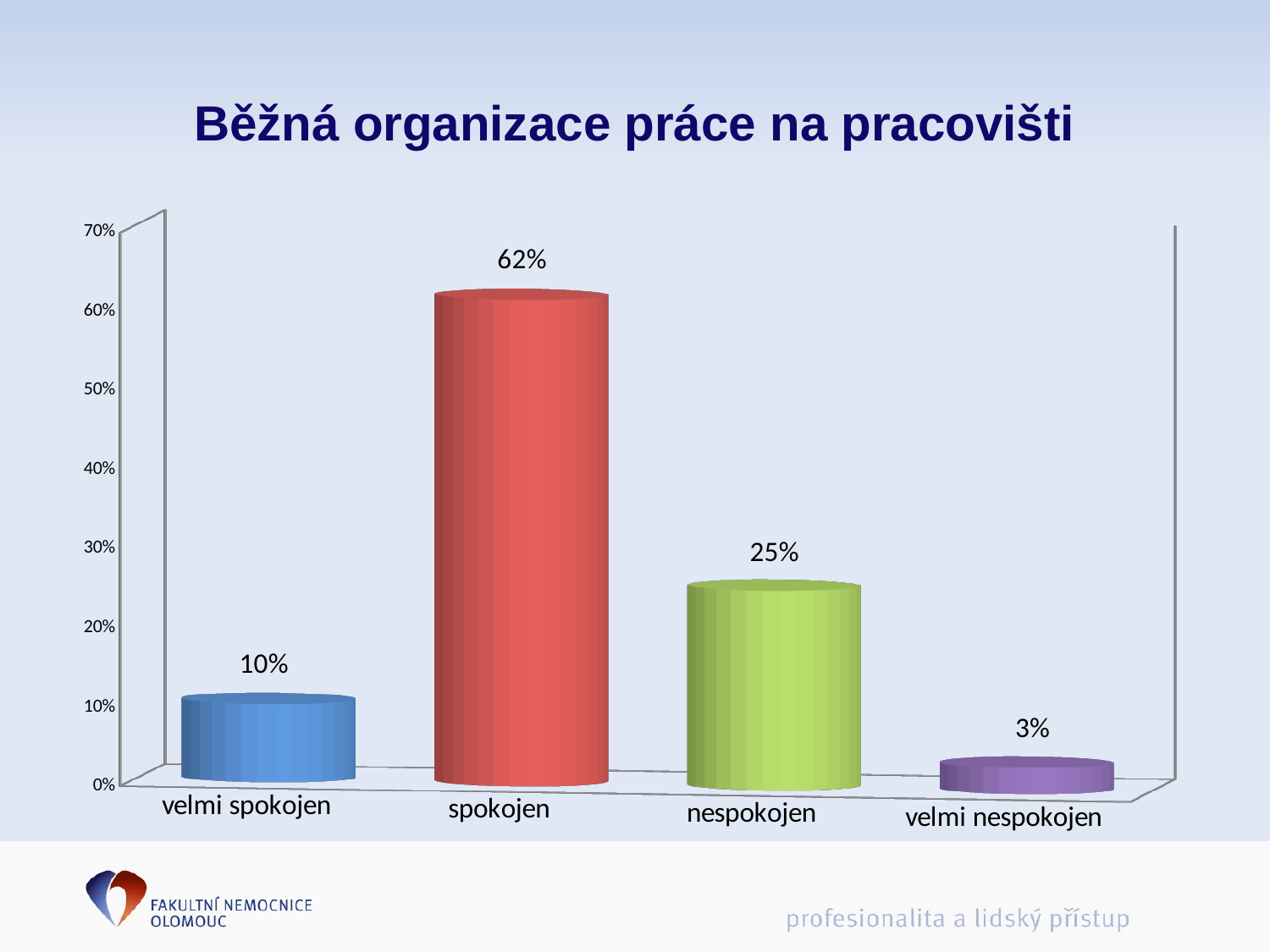
What kind of chart is shown on the slide? bar chart What is the value for "spokojen"? 62% Which category has the highest value? spokojen What is the value for "velmi nespokojen"? 3% Which is larger, the value for "velmi spokojen" or the value for "nespokojen"? nespokojen What is the value for "velmi spokojen"? 10% How many categories are shown on the x axis? 4 What is the difference between the values for "spokojen" and "nespokojen"? 37% Is the value for "spokojen" greater or less than 50%? greater Which category has the lowest value? velmi nespokojen What is the title of the chart? Běžná organizace práce na pracovišti What is the value for "nespokojen"? 25%